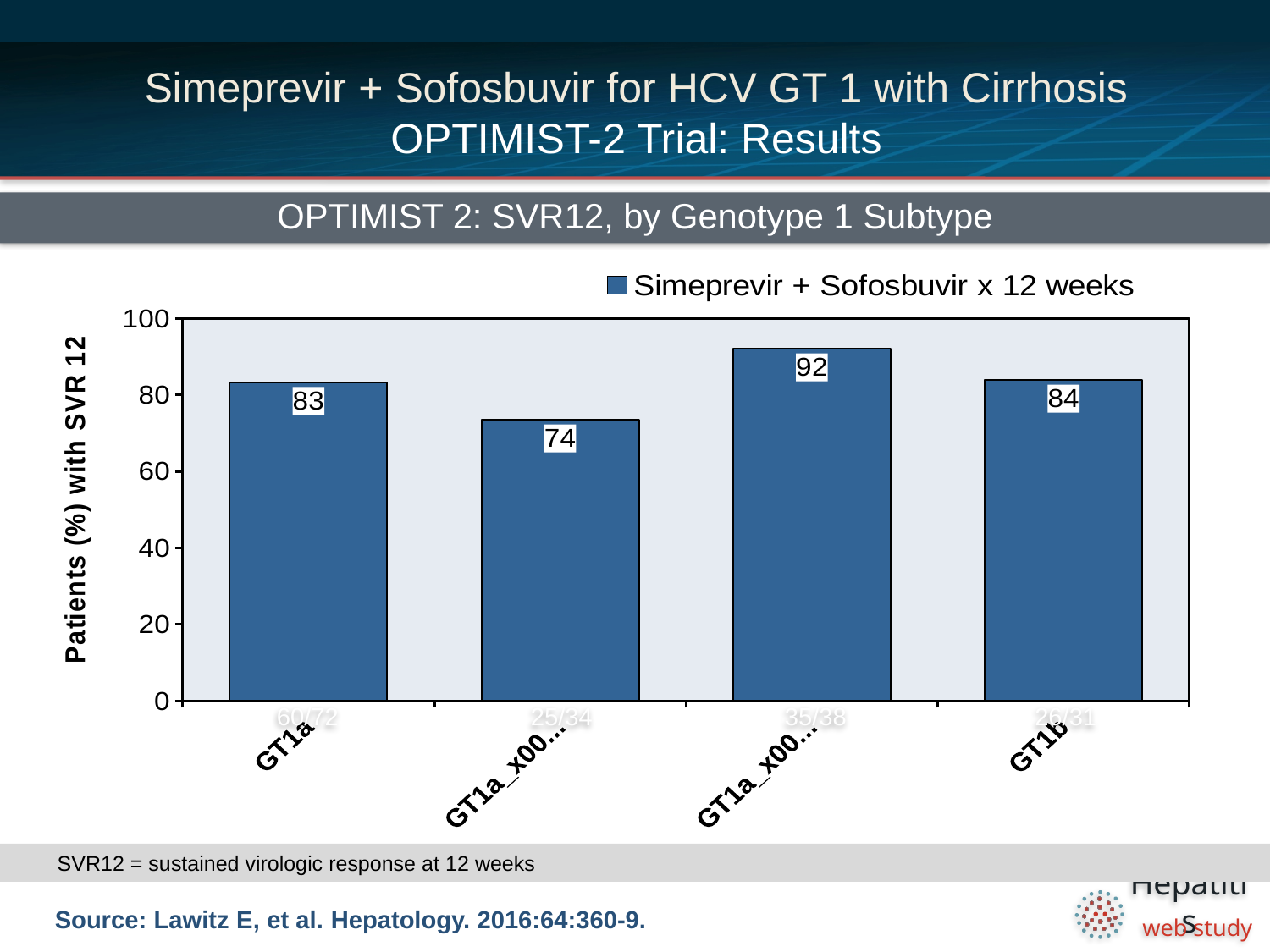
What is the highest value shown on the chart? 92 What is the difference between the highest and lowest values on the chart? 18 Which has a larger value, GT1a or GT1b? GT1b How many series does the legend list? 1 What is the value for GT1b? 84 What kind of chart is shown on the slide? bar chart Is the value for GT1a greater or less than 80? greater What is the value of the second bar from the left? 74 How many bars are shown on the chart? 4 What is the value for GT1a? 83 What is the lowest value shown on the chart? 74 What is the difference between the value for GT1b and the value for GT1a? 1